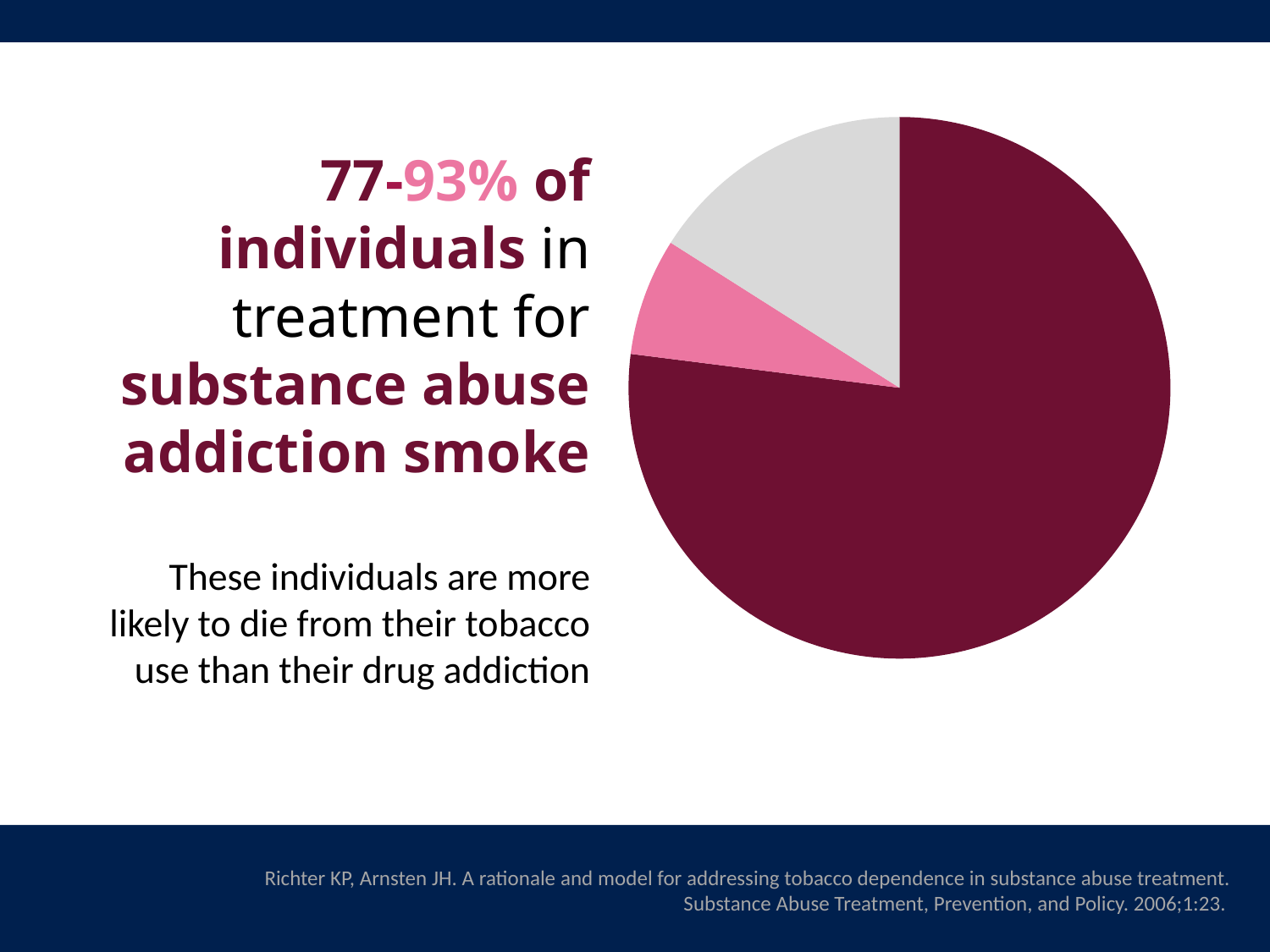
Does the pie chart have a legend? No How many slices does the pie chart have? 3 What percentage range does the slide text give for individuals in treatment for substance abuse addiction who smoke? 77-93% Is the dark red slice of the pie chart greater or less than 50% of the pie? greater What kind of chart is shown on the slide? pie chart Is the grey slice of the pie chart greater or less than 50% of the pie? less Which colour slice is the largest in the pie chart? dark red (maroon) Is the dark red slice larger or smaller than the pink slice? larger